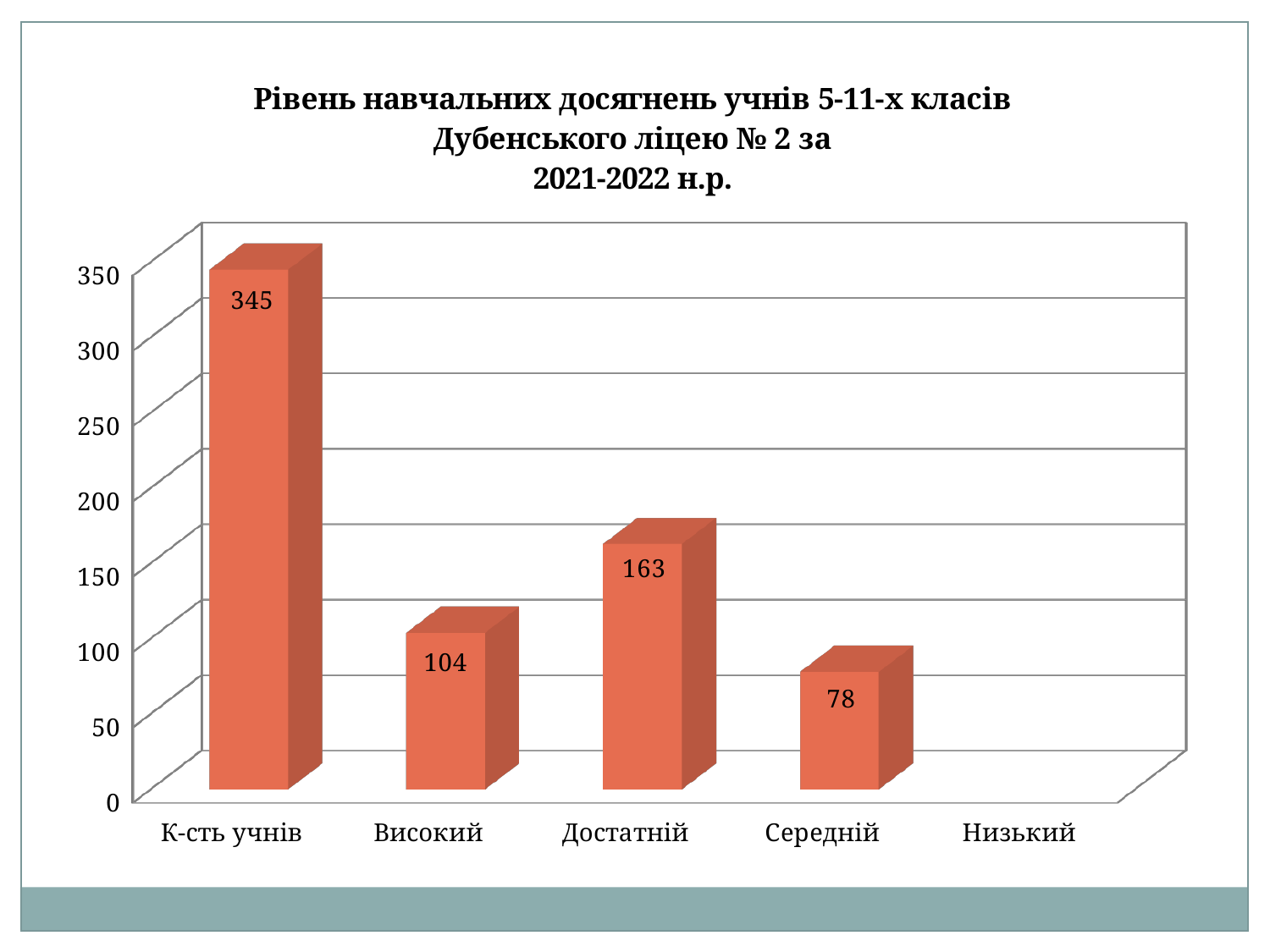
What is the value for Високий? 104 How many categories are shown on the x axis? 5 Which school year does the chart title refer to? 2021-2022 н.р. What is the value for Достатній? 163 Which category has the highest value? К-сть учнів What is the value for К-сть учнів? 345 Among Високий, Достатній and Середній, which has the lowest value? Середній What is the difference between the values for Високий and Середній? 26 What is the value for Середній? 78 What is the difference between the values for Достатній and Високий? 59 What kind of chart is shown on the slide? Bar chart Which is larger, the value for Достатній or the value for Середній? Достатній